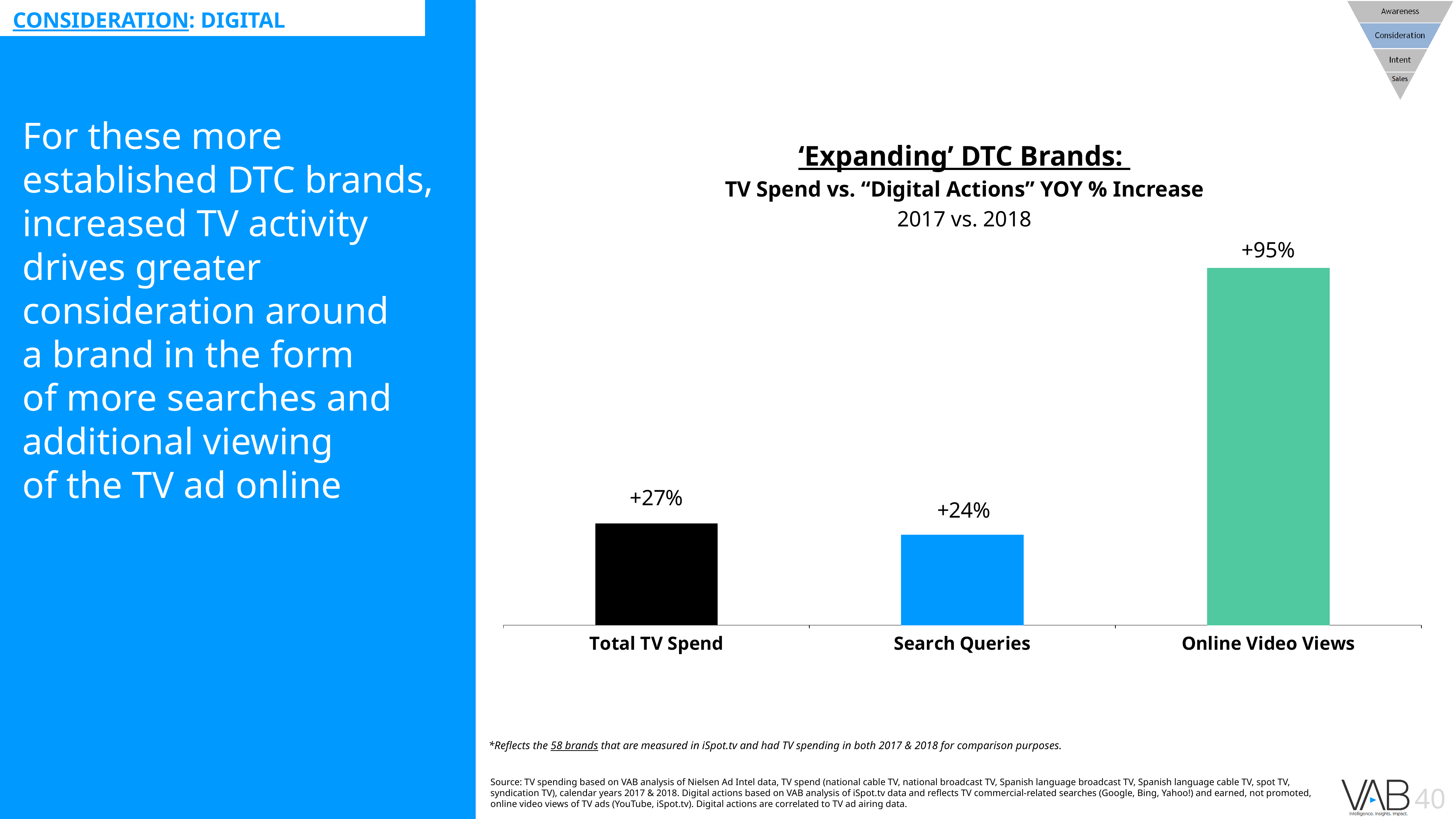
What is the YOY % increase shown for Search Queries? +24% Which category has the highest YOY % increase? Online Video Views What is the difference in percentage points between the Total TV Spend increase and the Search Queries increase? 3 What is the YOY % increase shown for Total TV Spend? +27% What type of chart is shown on the slide? Bar chart What two years does the chart compare, according to its title? 2017 vs. 2018 What is the difference in percentage points between the Online Video Views increase and the Total TV Spend increase? 68 What is the YOY % increase shown for Online Video Views? +95% What colour is the bar for Online Video Views? Green Which category has the lowest YOY % increase? Search Queries Which is larger, the YOY increase for Online Video Views or for Search Queries? Online Video Views How many categories are shown in the chart? 3